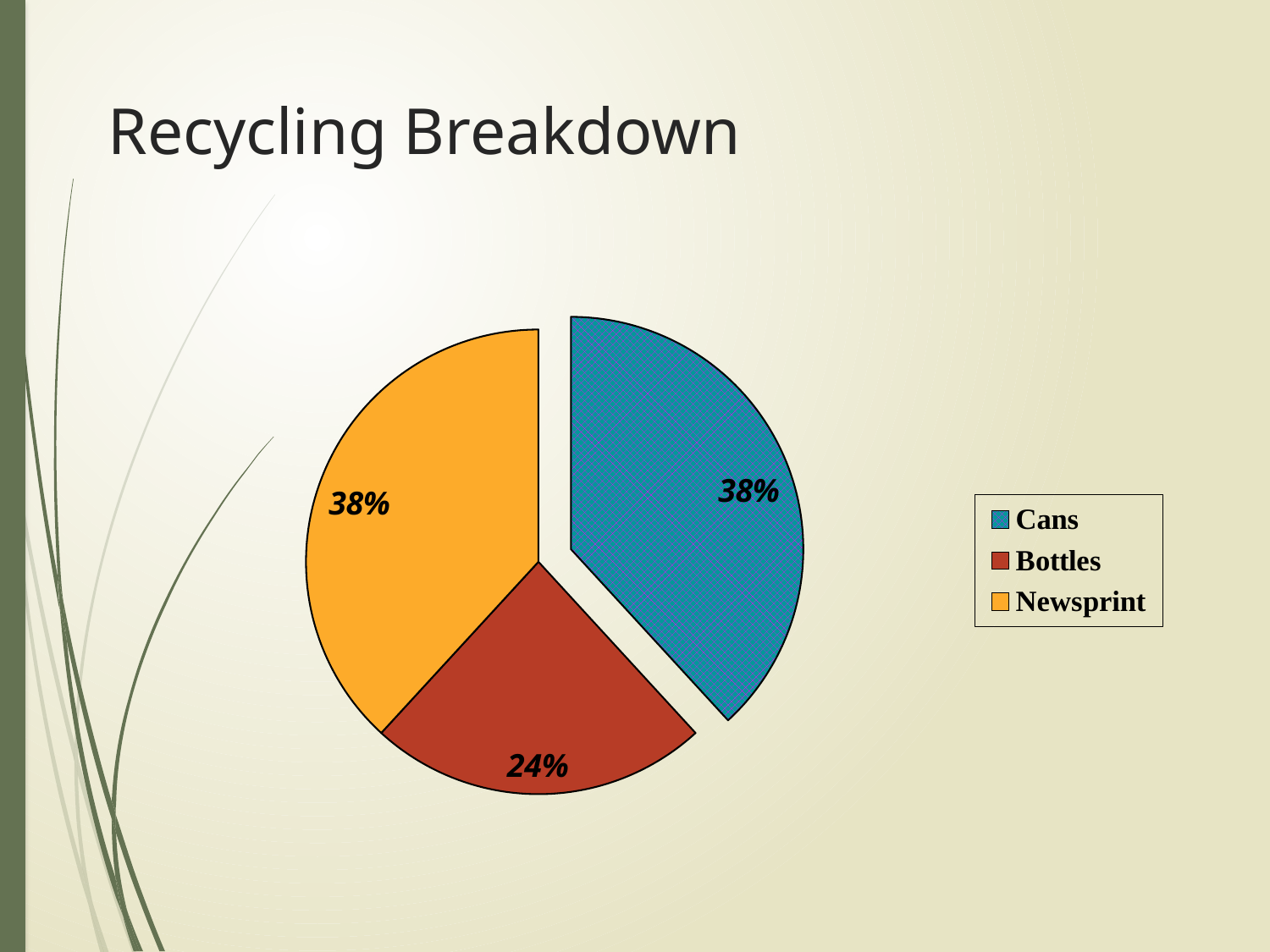
What kind of chart is shown on the slide? Pie chart Which category has the smallest share of the pie? Bottles What is the difference between the share for Newsprint and the share for Bottles? 14% How many slices does the pie chart have? 3 What percentage of the pie does Cans account for? 38% What percentage of the pie does Bottles account for? 24% Which is larger, the share for Cans or the share for Bottles? Cans What is the combined share of Cans and Newsprint? 76% What percentage of the pie does Newsprint account for? 38% Which slice is pulled out (exploded) from the rest of the pie? Cans What is the title of the slide containing the chart? Recycling Breakdown How many entries does the legend list? 3